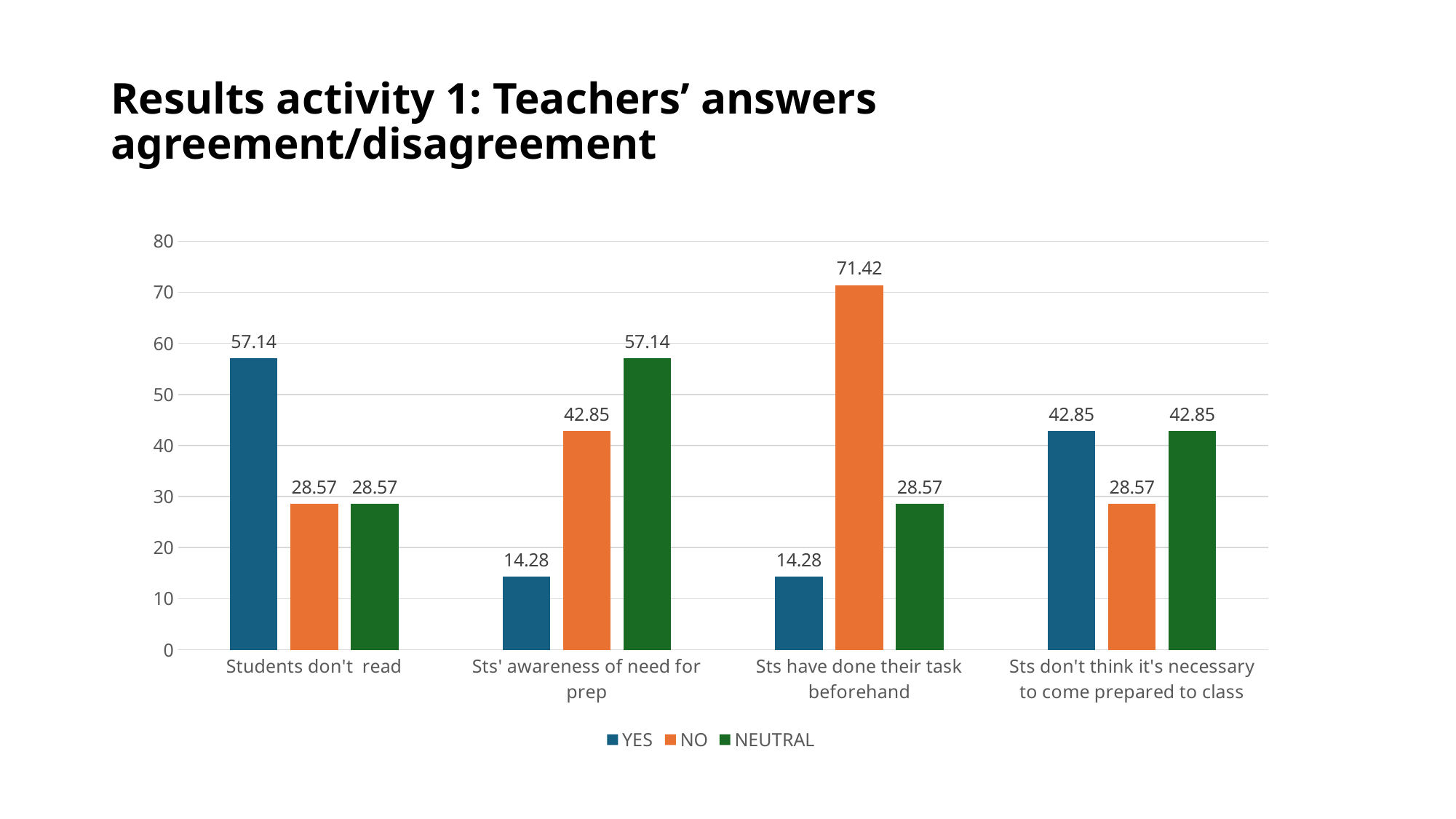
For "Sts' awareness of need for prep", which is larger, the NO value or the NEUTRAL value? NEUTRAL How many series does the legend list? 3 Which category has the highest NO value? Sts have done their task beforehand What is the YES value for "Sts don't think it's necessary to come prepared to class"? 42.85 What is the difference between the NO and YES values for "Sts have done their task beforehand"? 57.14 What is the NO value for "Sts have done their task beforehand"? 71.42 How many categories are shown on the x axis? 4 What is the YES value for "Students don't read"? 57.14 What is the NEUTRAL value for "Sts' awareness of need for prep"? 57.14 Which colour represents the NO series? Orange What kind of chart is shown on the slide? Bar chart